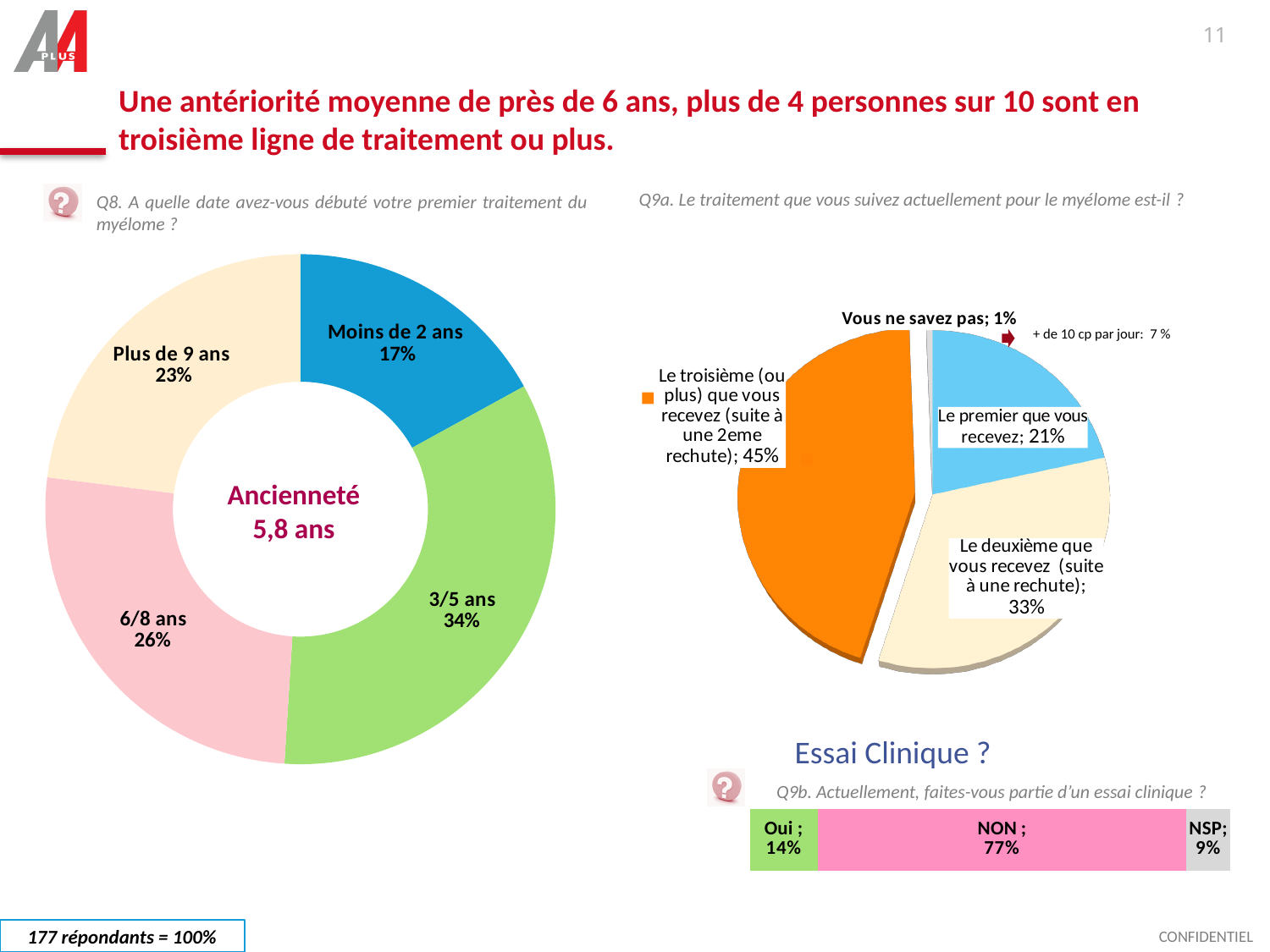
In the right pie chart (Q9a), what percentage of respondents are on their first treatment ("Le premier que vous recevez")? 21% In the right pie chart (Q9a), which category has the smallest share? Vous ne savez pas In the left donut chart (Q8), which category has the smallest share? Moins de 2 ans In the left donut chart (Q8), what percentage of respondents started their first treatment less than 2 years ago ("Moins de 2 ans")? 17% In the right pie chart (Q9a), which is larger: the share on the second treatment line or the share on the first treatment line? Le deuxième que vous recevez (33%) In the right pie chart (Q9a), what percentage of respondents are on the third (or more) treatment line? 45% What average seniority ("Ancienneté") is printed in the centre of the left donut chart? 5,8 ans In the left donut chart (Q8), what is the difference in percentage points between "6/8 ans" and "Plus de 9 ans"? 3 In the left donut chart (Q8), which category has the largest share? 3/5 ans In the "Essai Clinique ?" bar chart (Q9b), what is the difference in percentage points between "Oui" and "NSP"? 5 In the left donut chart (Q8), how many categories are shown? 4 In the "Essai Clinique ?" bar chart (Q9b), what percentage of respondents answered "NON"? 77%